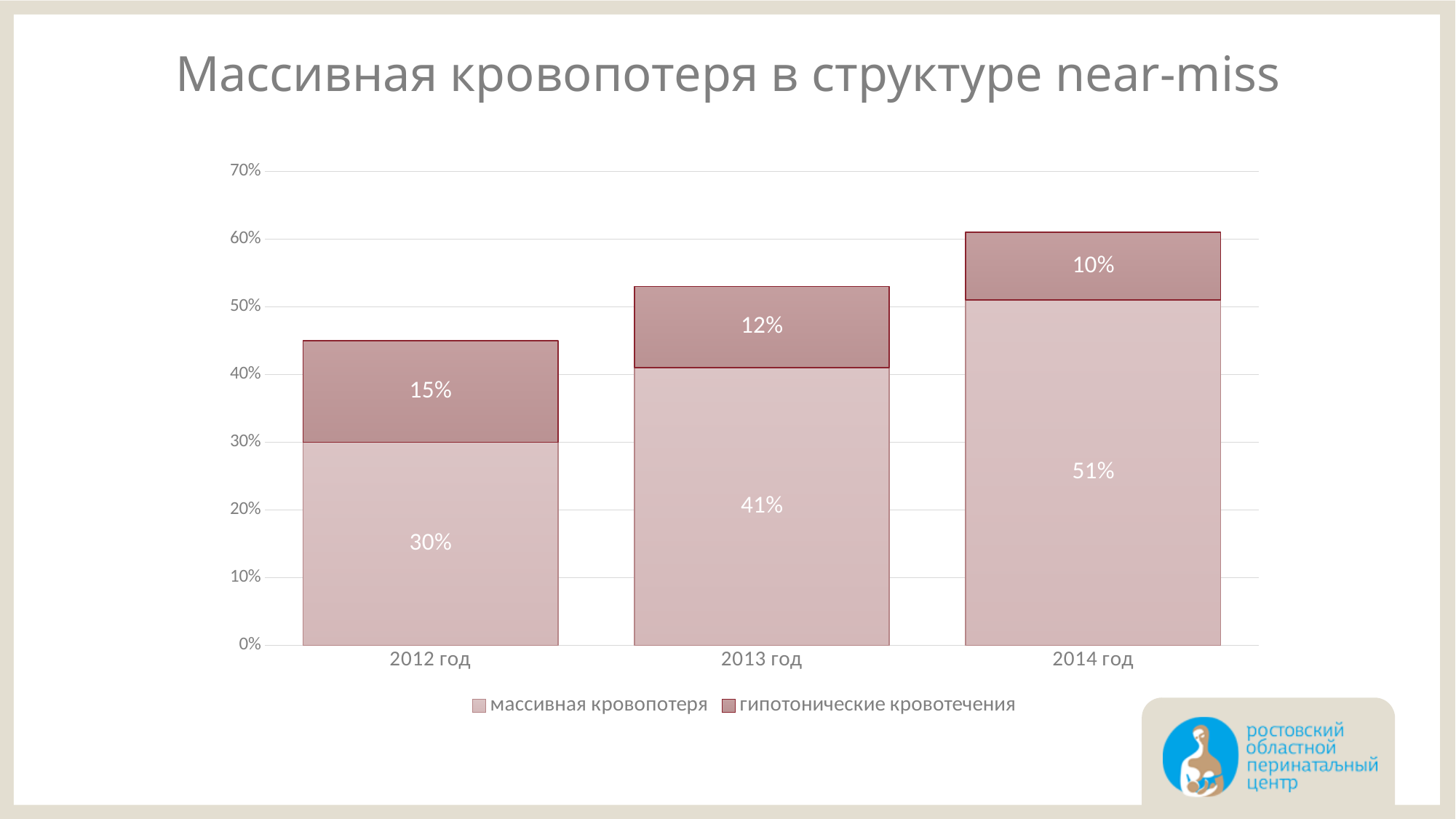
What is the total of the stacked bar for 2013 год? 53% What is the value for массивная кровопотеря in 2014 год? 51% Which year has the highest value for массивная кровопотеря? 2014 год Does the value for массивная кровопотеря rise or fall from 2012 год to 2014 год? Rise Which year has the lowest value for гипотонические кровотечения? 2014 год What is the value for гипотонические кровотечения in 2013 год? 12% How many series does the legend list? 2 What is the value for массивная кровопотеря in 2012 год? 30% What is the difference between the массивная кровопотеря values for 2014 год and 2012 год? 21% How many years are shown on the x axis? 3 Which is larger: гипотонические кровотечения in 2012 год or in 2013 год? 2012 год What kind of chart is shown on the slide? Stacked bar chart